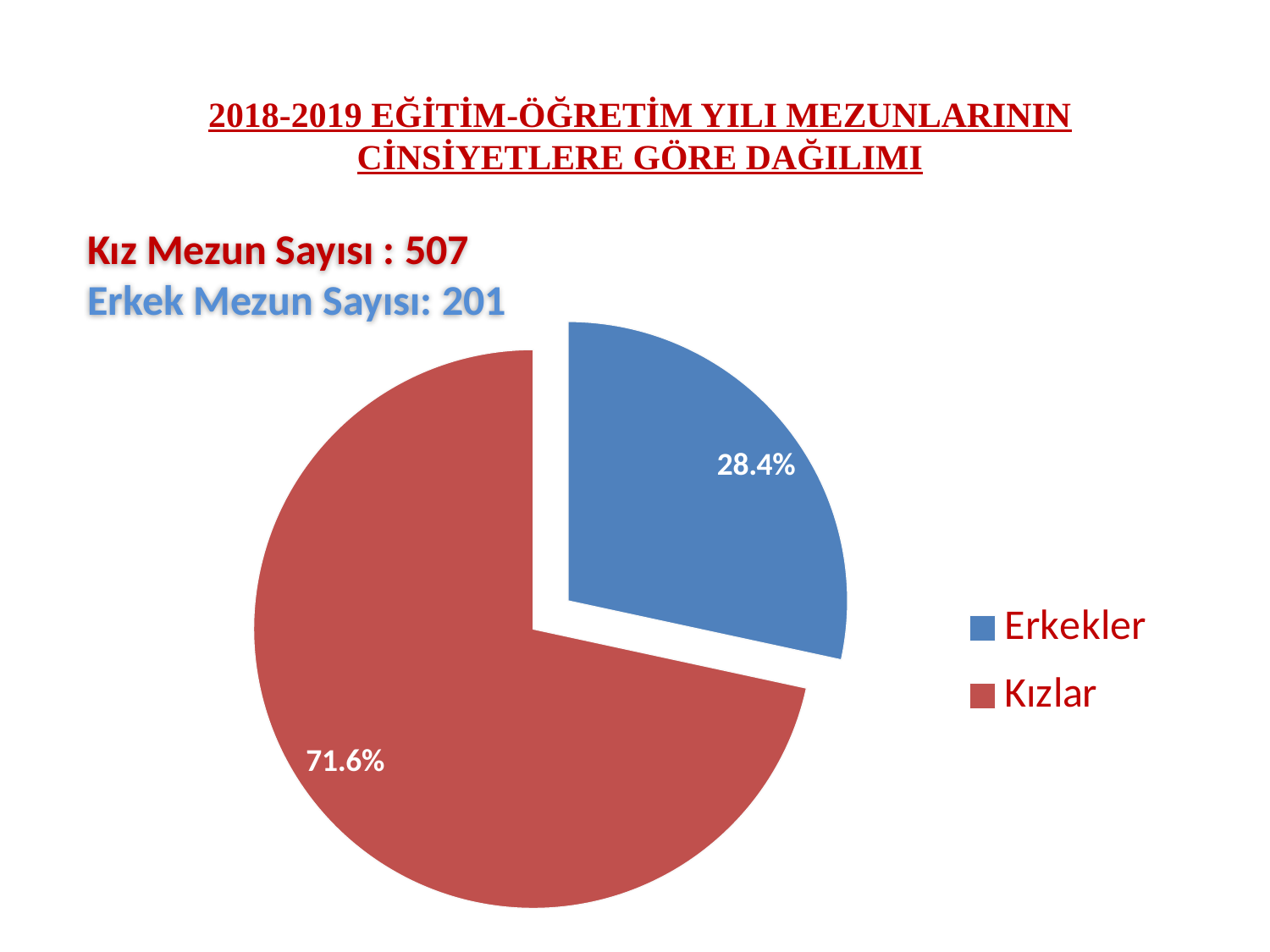
What percentage share does the Kızlar slice have? 71.6% What kind of chart is shown on the slide? pie chart Which slice is the largest in the pie chart? Kızlar Which is larger, the Erkekler slice or the Kızlar slice? Kızlar What percentage share does the Erkekler slice have? 28.4% How many entries does the legend list? 2 What colour is the Kızlar slice? red What is the difference in percentage points between the Kızlar and Erkekler slices? 43.2 What colour is the Erkekler slice? blue Is the share of the Kızlar slice greater or less than 50%? greater Which slice is the smallest in the pie chart? Erkekler How many slices does the pie chart have? 2